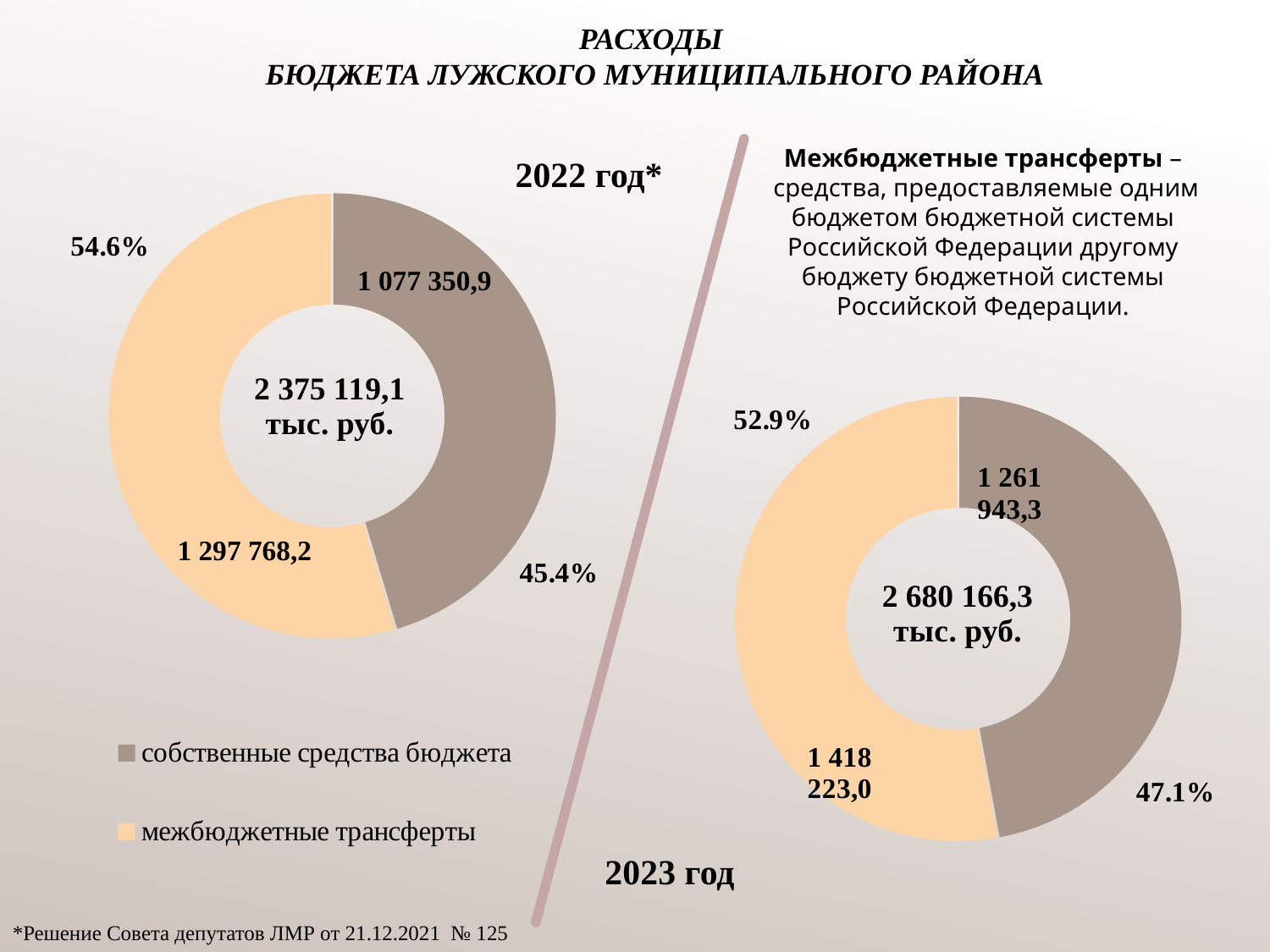
In the 2023 chart, what share of the total do собственные средства бюджета make up? 47.1% How many categories does the legend list? 2 What kind of chart is used for the 2022 data? doughnut chart In the 2023 chart, what is the value for межбюджетные трансферты? 1 418 223,0 In the 2023 chart, which category is the largest? межбюджетные трансферты What total is shown in the centre of the 2023 chart? 2 680 166,3 тыс. руб. What total is shown in the centre of the 2022 chart? 2 375 119,1 тыс. руб. In the 2022 chart, what is the value for межбюджетные трансферты? 1 297 768,2 In the 2022 chart, which category is the smallest? собственные средства бюджета In the 2023 chart, what is the value for собственные средства бюджета? 1 261 943,3 In the 2022 chart, what is the value for собственные средства бюджета? 1 077 350,9 In the 2022 chart, what share of the total do межбюджетные трансферты make up? 54.6%